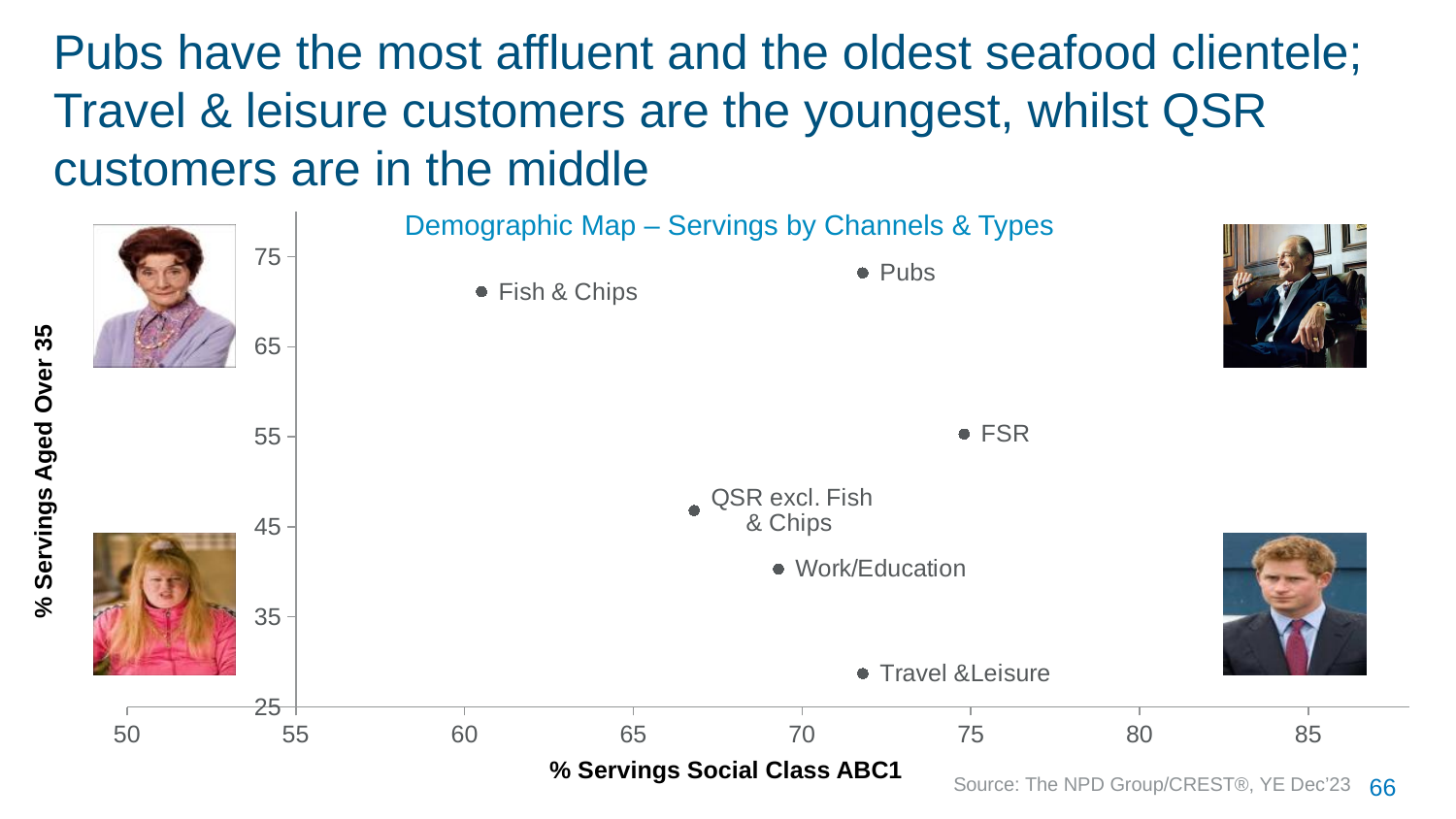
Is the % Servings Social Class ABC1 for Fish & Chips greater or less than 65? less Is the % Servings Social Class ABC1 for FSR greater or less than 70? greater Is the % Servings Aged Over 35 for Travel & Leisure greater or less than 35? less How many labelled points are plotted on the chart? 6 Which point has the lowest % Servings Social Class ABC1? Fish & Chips Which point has the lowest % Servings Aged Over 35? Travel & Leisure Which has a higher % Servings Aged Over 35, FSR or Work/Education? FSR What is the label of the horizontal axis? % Servings Social Class ABC1 What is the title of the chart? Demographic Map – Servings by Channels & Types What kind of chart is shown on the slide? Scatter chart Which point has the highest % Servings Social Class ABC1? FSR